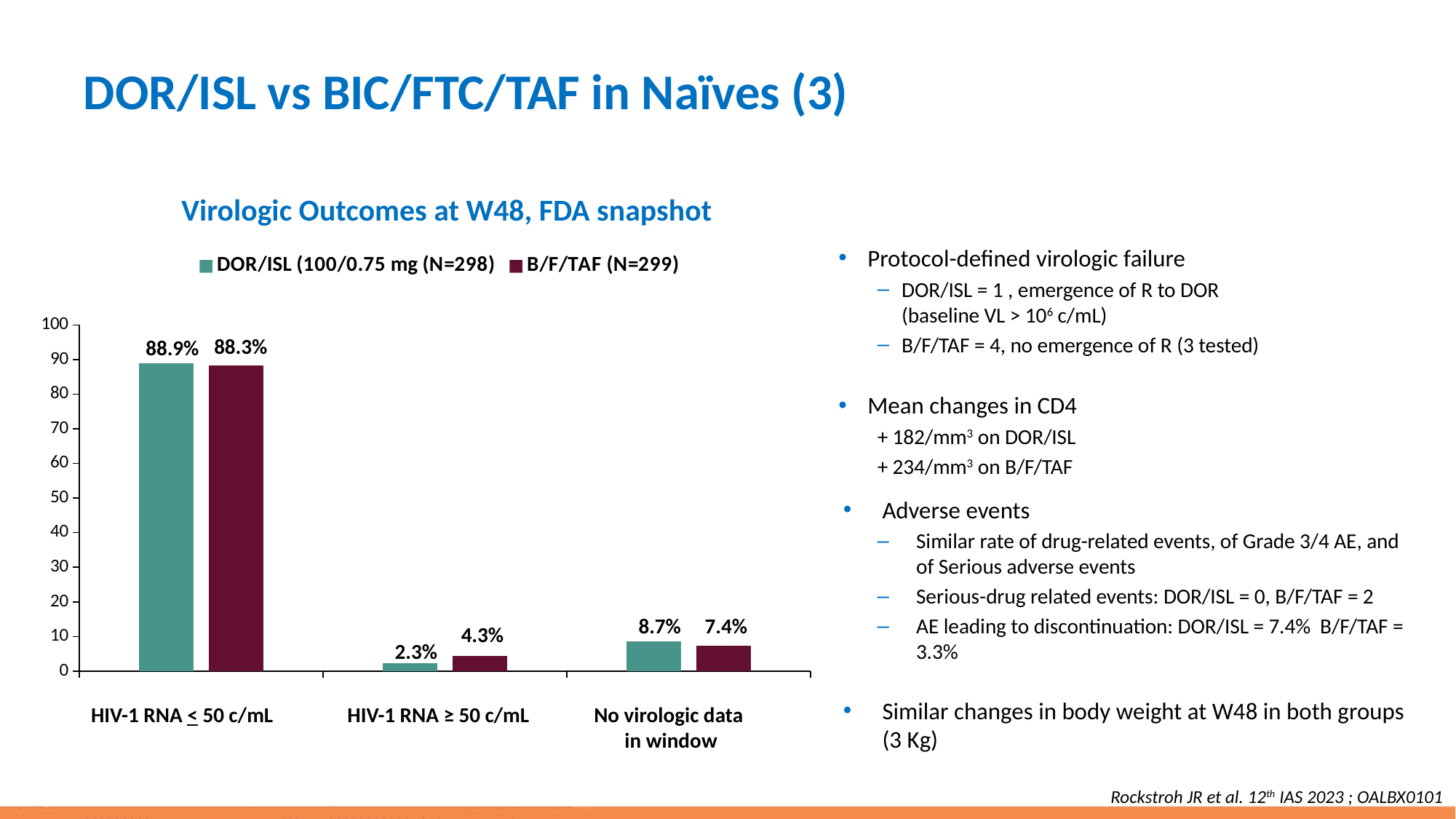
What type of chart is shown on the slide? Bar chart Which category has the highest value for the DOR/ISL series? HIV-1 RNA < 50 c/mL What is the value for B/F/TAF in the HIV-1 RNA ≥ 50 c/mL category? 4.3% What is the value for DOR/ISL in the No virologic data in window category? 8.7% Which category has the lowest value for the B/F/TAF series? HIV-1 RNA ≥ 50 c/mL Is the value for DOR/ISL in the HIV-1 RNA < 50 c/mL category greater or less than 80? greater How many series does the legend list? 2 What is the difference between the B/F/TAF and DOR/ISL values in the HIV-1 RNA ≥ 50 c/mL category? 2.0% What is the value for DOR/ISL in the HIV-1 RNA < 50 c/mL category? 88.9% What is the value for B/F/TAF in the No virologic data in window category? 7.4% In the No virologic data in window category, which series has the larger value, DOR/ISL or B/F/TAF? DOR/ISL How many categories are shown on the x axis? 3